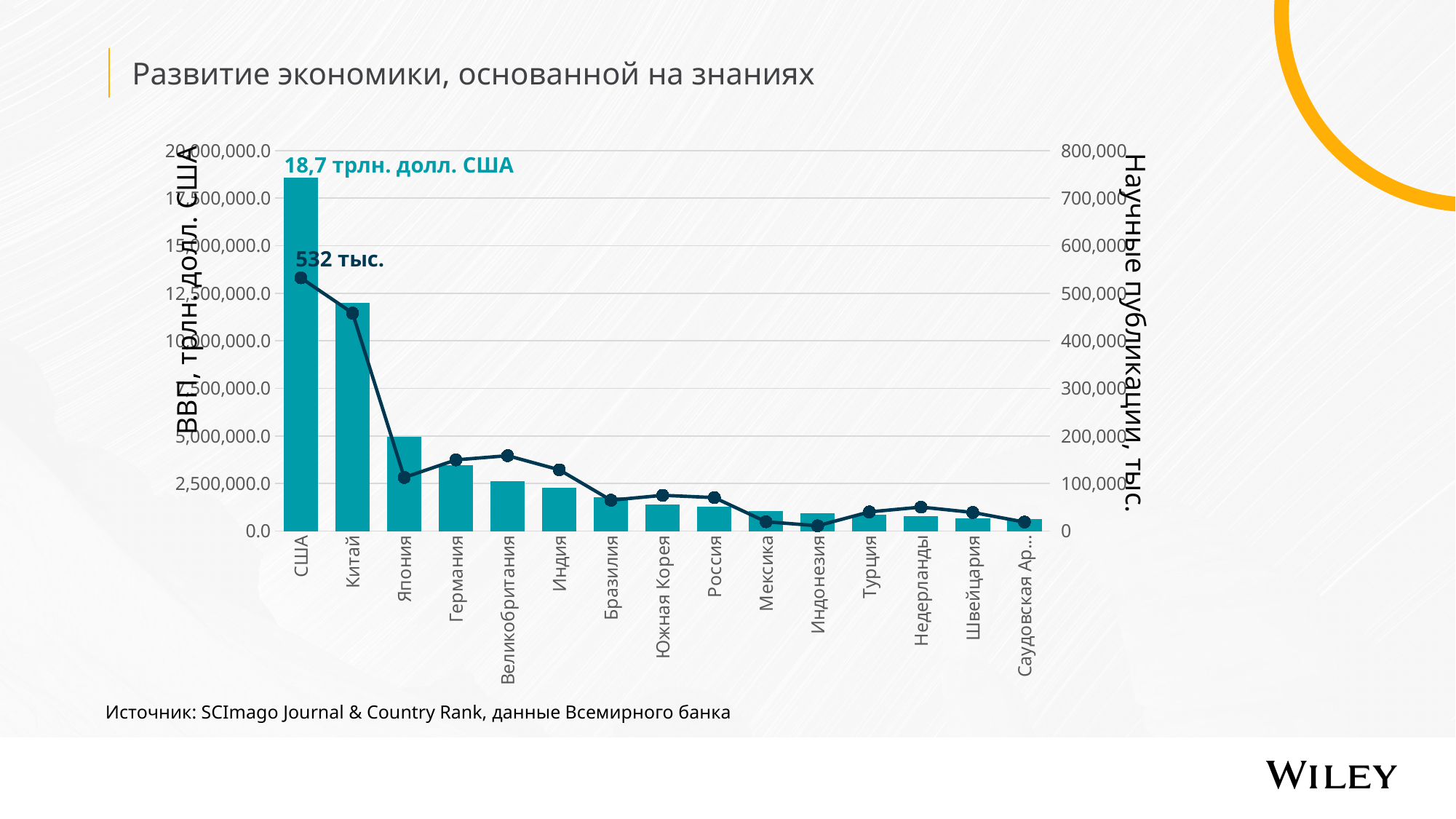
Which has the higher publications line point, Япония or Германия? Германия Is the GDP bar for Германия greater or less than 2,500,000.0? greater What value is labelled on the line point for США (scientific publications)? 532 тыс. Is the GDP bar for Китай greater or less than 10,000,000.0? greater Do the GDP bars generally rise or fall from left to right along the x axis? fall How many countries are shown on the x axis of the chart? 15 What kind of chart is shown on the slide? bar chart with a line What GDP value is labelled on the bar for США? 18,7 трлн. долл. США What is the title of the right-hand vertical axis? Научные публикации, тыс. Is the publications line point for Китай greater or less than 400,000? greater Which has the larger GDP bar, Китай or Япония? Китай Which country has the highest GDP bar in the chart? США